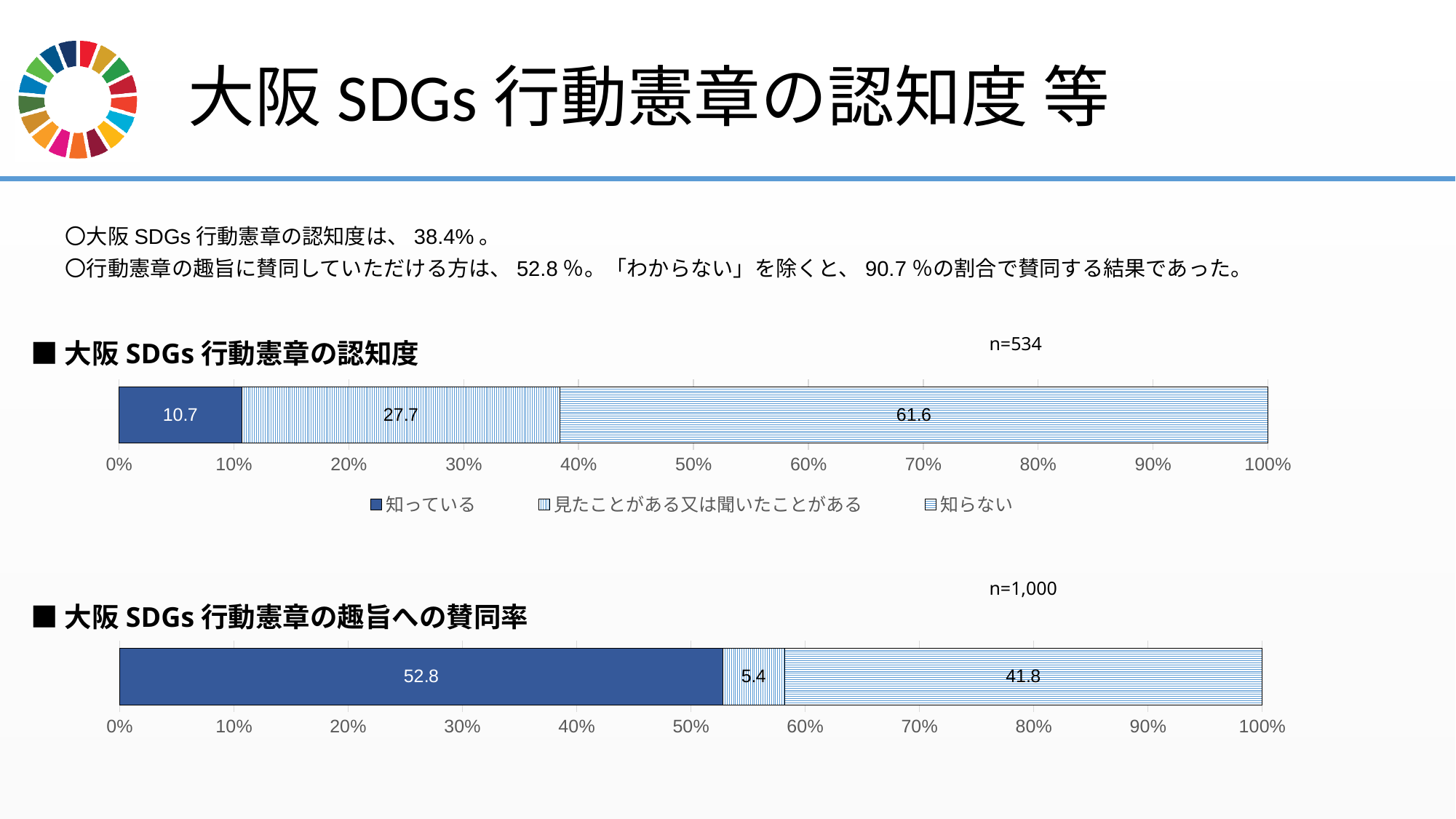
What kind of chart is the top chart (大阪 SDGs 行動憲章の認知度)? Stacked bar chart In the bottom chart (大阪 SDGs 行動憲章の趣旨への賛同率), what is the value of the leftmost (solid blue) segment? 52.8 In the top chart (大阪 SDGs 行動憲章の認知度), which segment has the smallest value? 知っている In the bottom chart (大阪 SDGs 行動憲章の趣旨への賛同率), what is the difference between the leftmost segment (52.8) and the rightmost segment (41.8)? 11.0 In the top chart (大阪 SDGs 行動憲章の認知度), how many series does the legend list? 3 In the bottom chart (大阪 SDGs 行動憲章の趣旨への賛同率), what is the value of the middle segment? 5.4 In the top chart (大阪 SDGs 行動憲章の認知度), what is the value for 知っている? 10.7 What sample size (n) is shown for the bottom chart (大阪 SDGs 行動憲章の趣旨への賛同率)? n=1,000 In the top chart (大阪 SDGs 行動憲章の認知度), which segment has the largest value? 知らない In the top chart (大阪 SDGs 行動憲章の認知度), what is the difference between the values for 知らない and 知っている? 50.9 In the top chart (大阪 SDGs 行動憲章の認知度), what is the value for 見たことがある又は聞いたことがある? 27.7 In the top chart (大阪 SDGs 行動憲章の認知度), what is the value for 知らない? 61.6